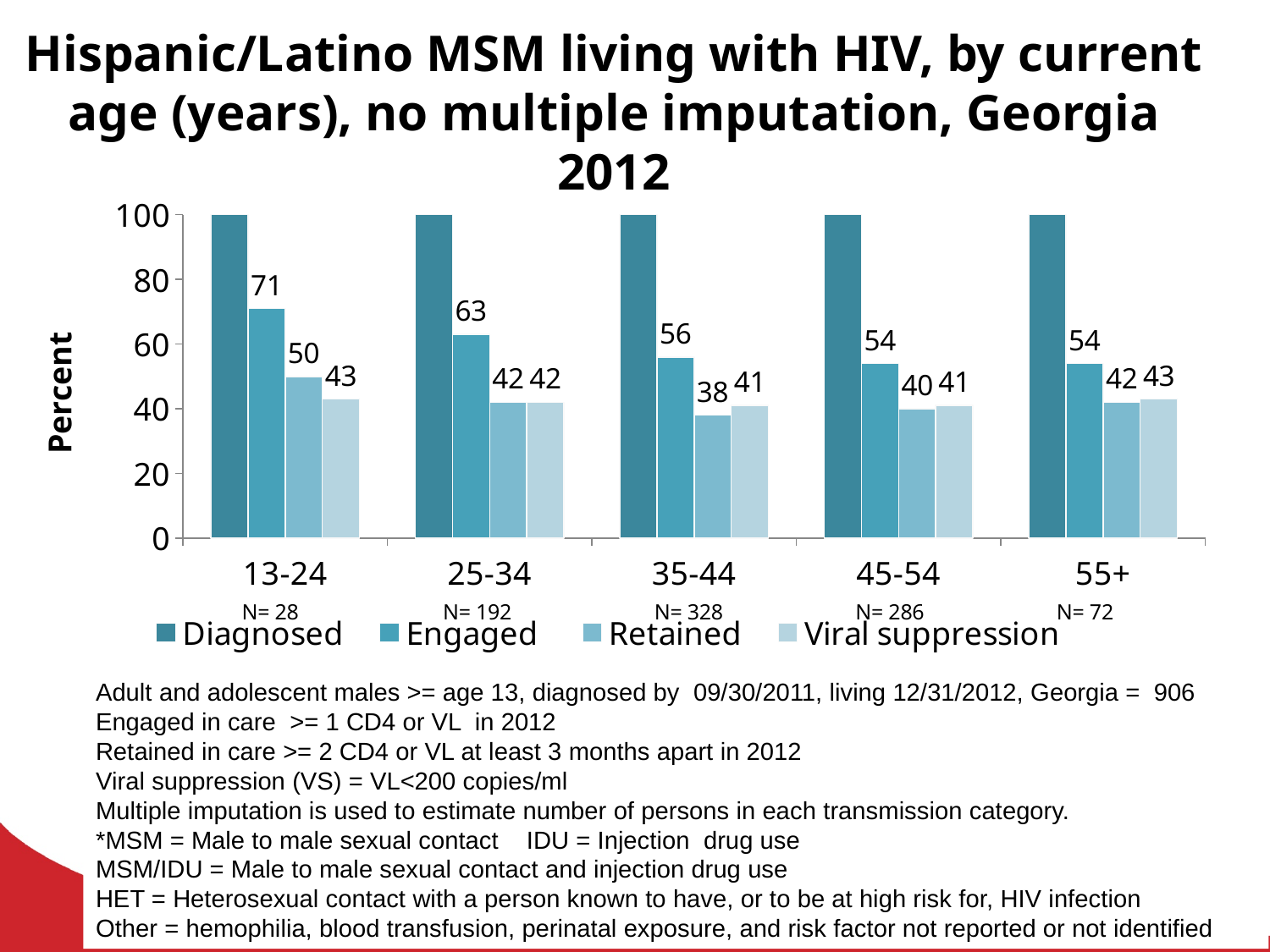
What is the label of the y axis? Percent Is the Engaged value for the 35-44 age group greater or less than 60? less What is the Engaged value for the 13-24 age group? 71 What is the Retained value for the 35-44 age group? 38 How many age groups are shown on the x axis? 5 What is the Viral suppression value for the 55+ age group? 43 What is the difference between the Engaged and Retained values for the 25-34 age group? 21 Which is larger, the Retained value for 13-24 or the Retained value for 45-54? Retained value for 13-24 How many series does the legend list? 4 Which age group has the lowest Retained value? 35-44 Which age group has the highest Engaged value? 13-24 What kind of chart is shown on the slide? bar chart